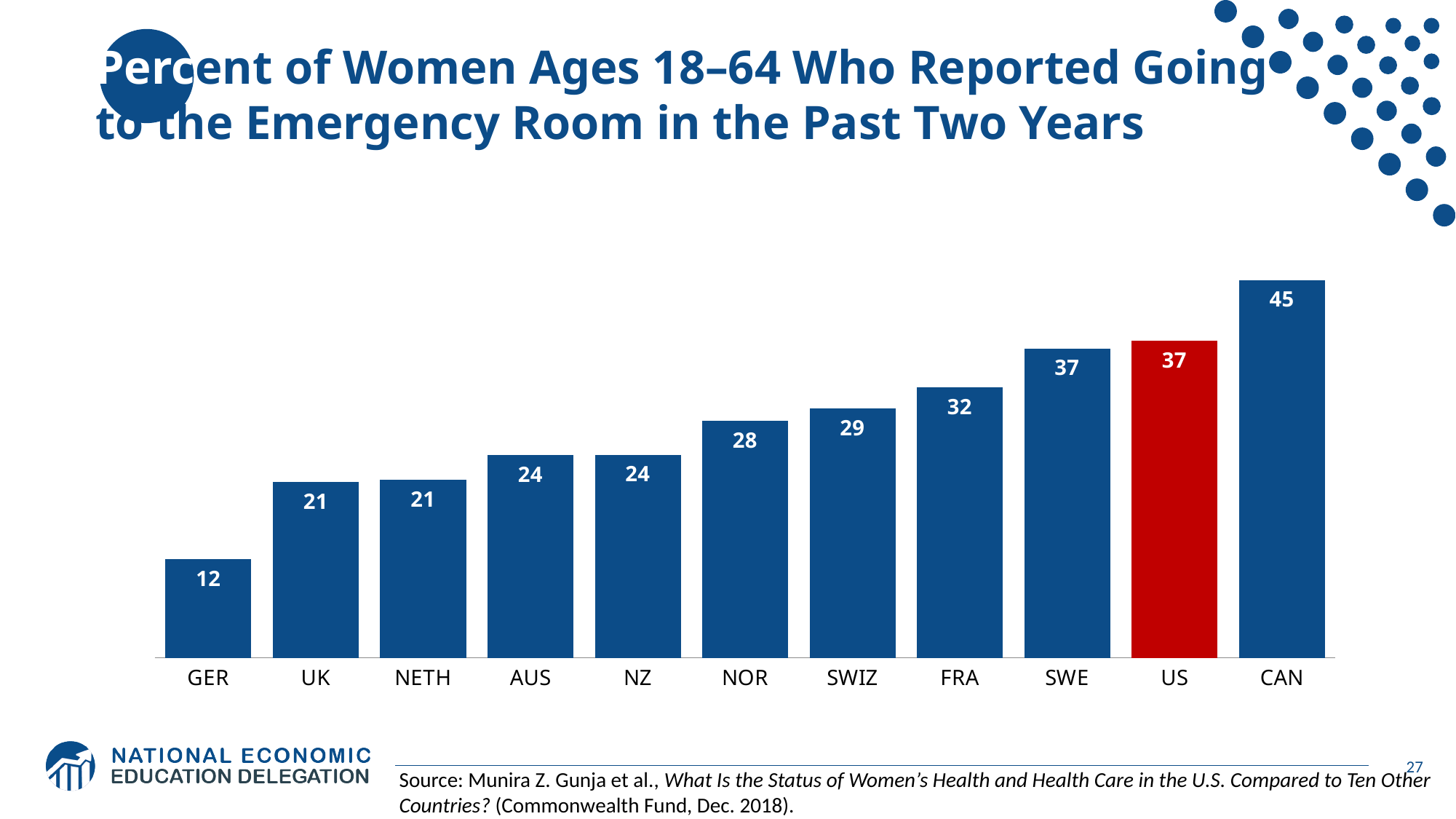
Which country has the highest value? CAN Which country has the lowest value? GER What kind of chart is this? bar chart What is the difference between the values for FRA and GER? 20 What is the value for the US? 37 What is the value for GER? 12 Do the values rise or fall from left to right along the x axis? rise What is the value for NOR? 28 Which is larger, the value for SWIZ or the value for AUS? SWIZ How many countries are shown on the chart? 11 What is the difference between the values for CAN and the US? 8 Which country's bar is coloured red? US